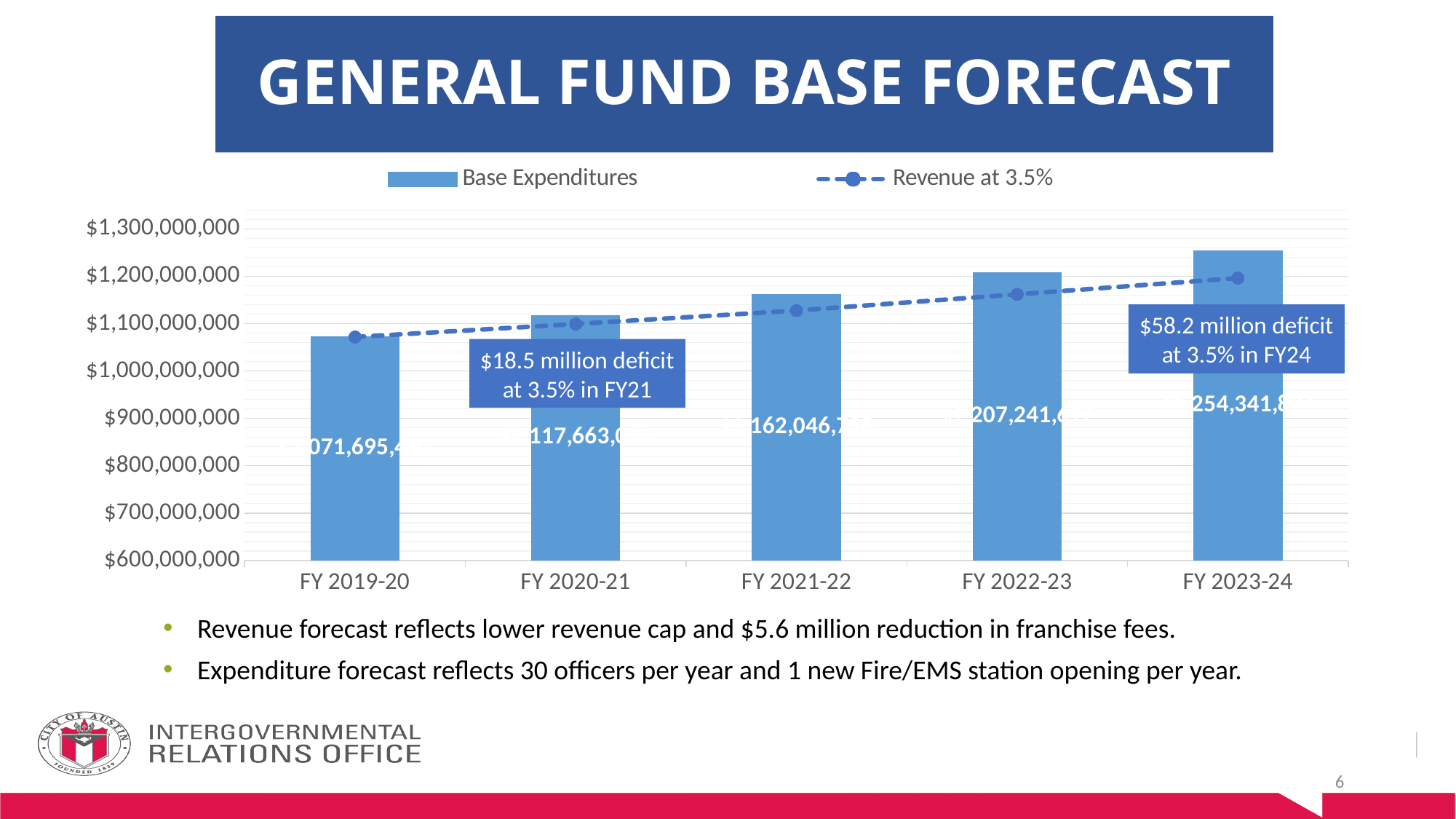
What is the title of the chart on the slide? General Fund Base Forecast What deficit does the chart annotation give for FY24 at 3.5%? $58.2 million Is the Base Expenditures value for FY 2023-24 greater or less than $1,200,000,000? greater Which fiscal year has the lowest Base Expenditures bar? FY 2019-20 What type of chart is shown on the slide? Bar chart with a line How many fiscal years are shown on the x axis of the chart? 5 Do Base Expenditures rise or fall from FY 2019-20 to FY 2023-24? Rise Which fiscal year has the highest Base Expenditures bar? FY 2023-24 Is the Base Expenditures value for FY 2019-20 greater or less than $1,100,000,000? less Which is larger in FY 2023-24, Base Expenditures or Revenue at 3.5%? Base Expenditures How many series does the chart legend list? 2